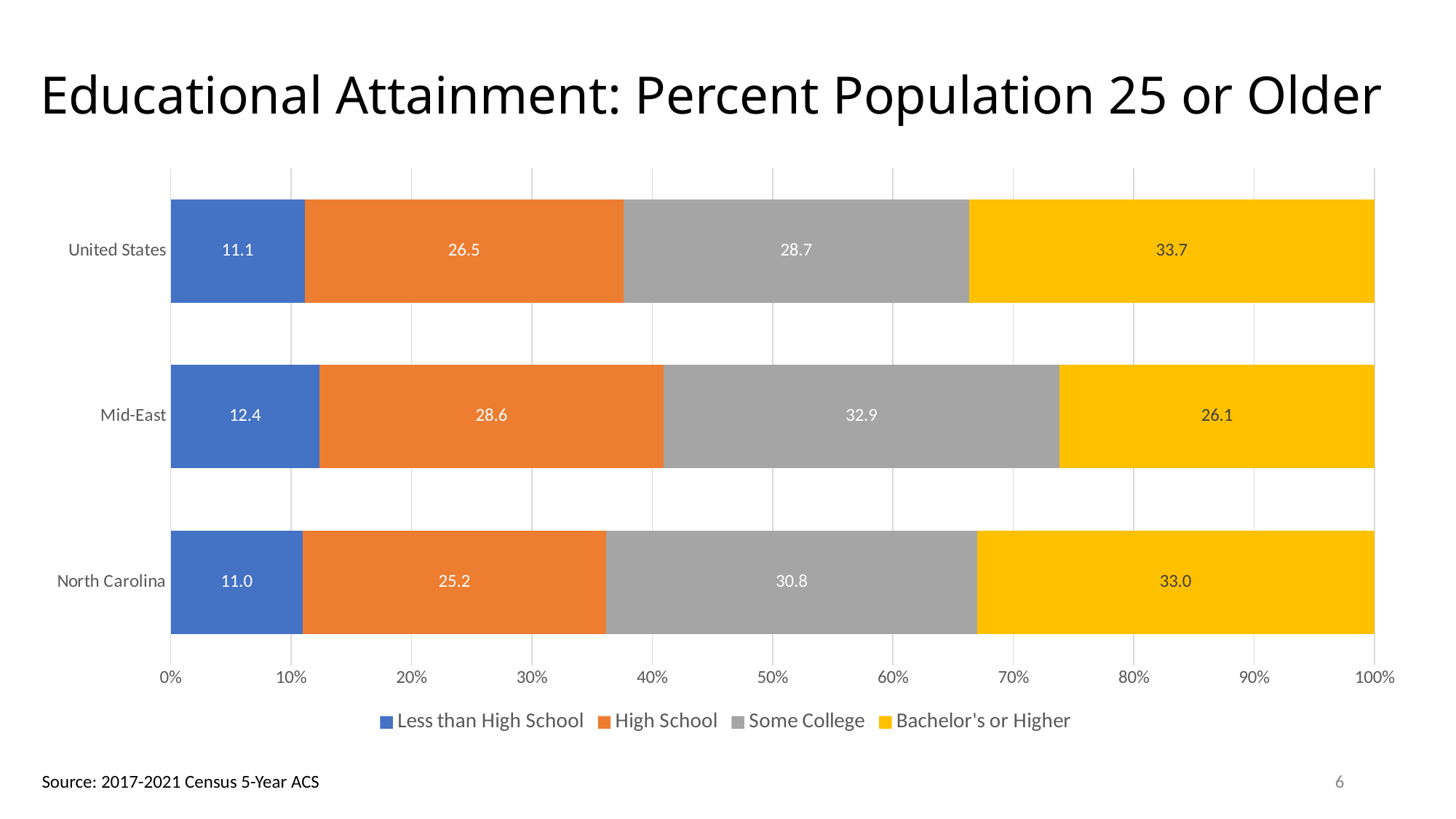
How many series does the legend list? 4 What is the title of the chart? Educational Attainment: Percent Population 25 or Older What kind of chart is shown on the slide? Stacked bar chart Which region has the highest value for Less than High School? Mid-East What is the value for High School for North Carolina? 25.2 What is the total of the stacked bar for North Carolina? 100.0 Which region has the lowest value for Bachelor's or Higher? Mid-East What is the value for Some College for Mid-East? 32.9 What is the difference between the Some College values for Mid-East and the United States? 4.2 What is the value for Bachelor's or Higher for the United States? 33.7 Which is larger, the High School value for the United States or for North Carolina? United States How many regions are shown on the chart? 3